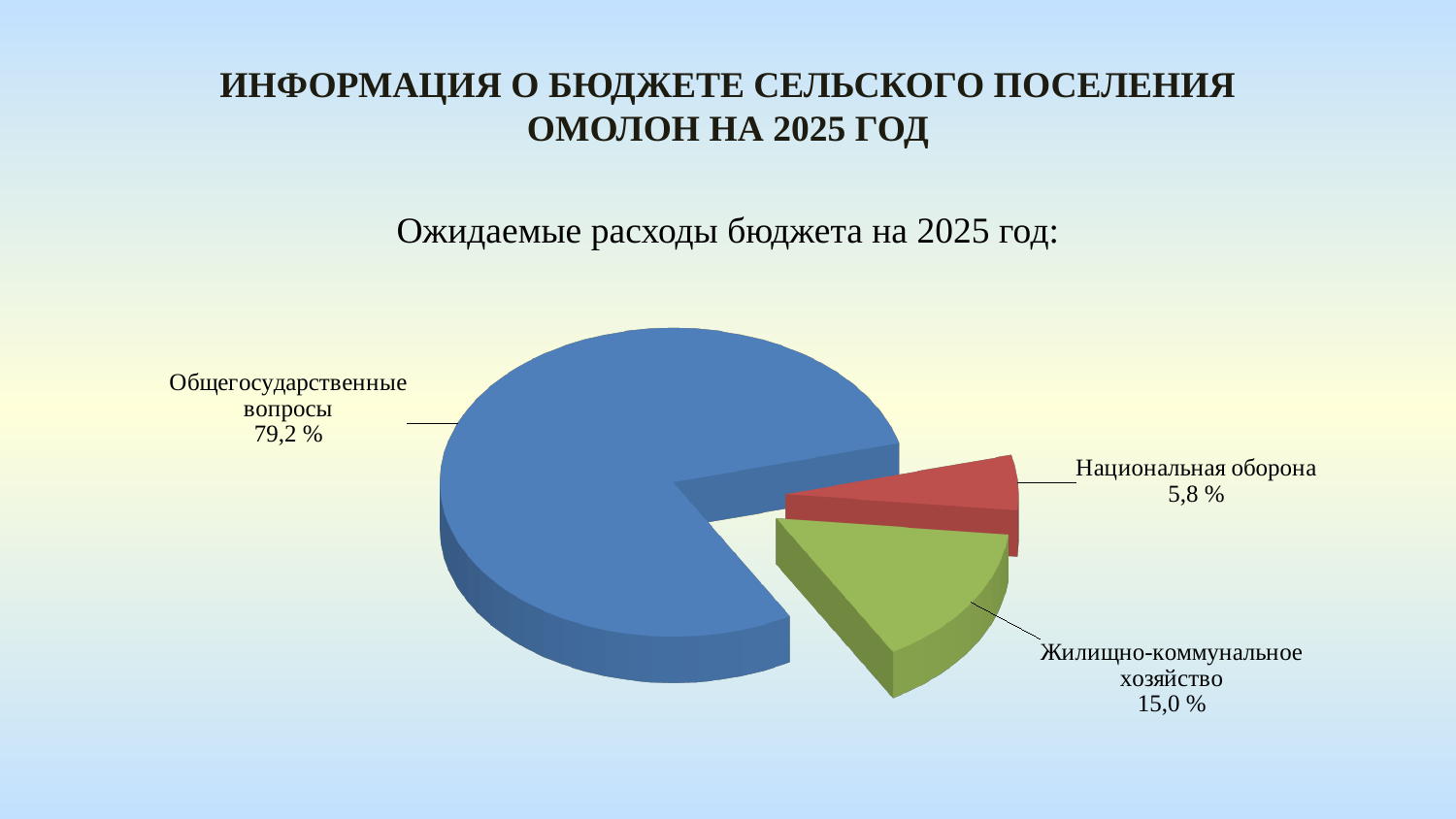
Which category has the smallest share of the expected 2025 budget expenditures? Национальная оборона What share of expected 2025 budget expenditures goes to Национальная оборона? 5,8 % What is the difference in percentage points between Жилищно-коммунальное хозяйство and Национальная оборона? 9,2 What kind of chart is shown on the slide? pie chart What colour is the slice for Национальная оборона? red What share of expected 2025 budget expenditures goes to Общегосударственные вопросы? 79,2 % What is the difference in percentage points between Общегосударственные вопросы and Жилищно-коммунальное хозяйство? 64,2 Which category has the largest share of the expected 2025 budget expenditures? Общегосударственные вопросы What share of expected 2025 budget expenditures goes to Жилищно-коммунальное хозяйство? 15,0 % How many categories are shown in the pie chart? 3 Which is larger: the share for Жилищно-коммунальное хозяйство or the share for Национальная оборона? Жилищно-коммунальное хозяйство What is the subtitle above the pie chart? Ожидаемые расходы бюджета на 2025 год: